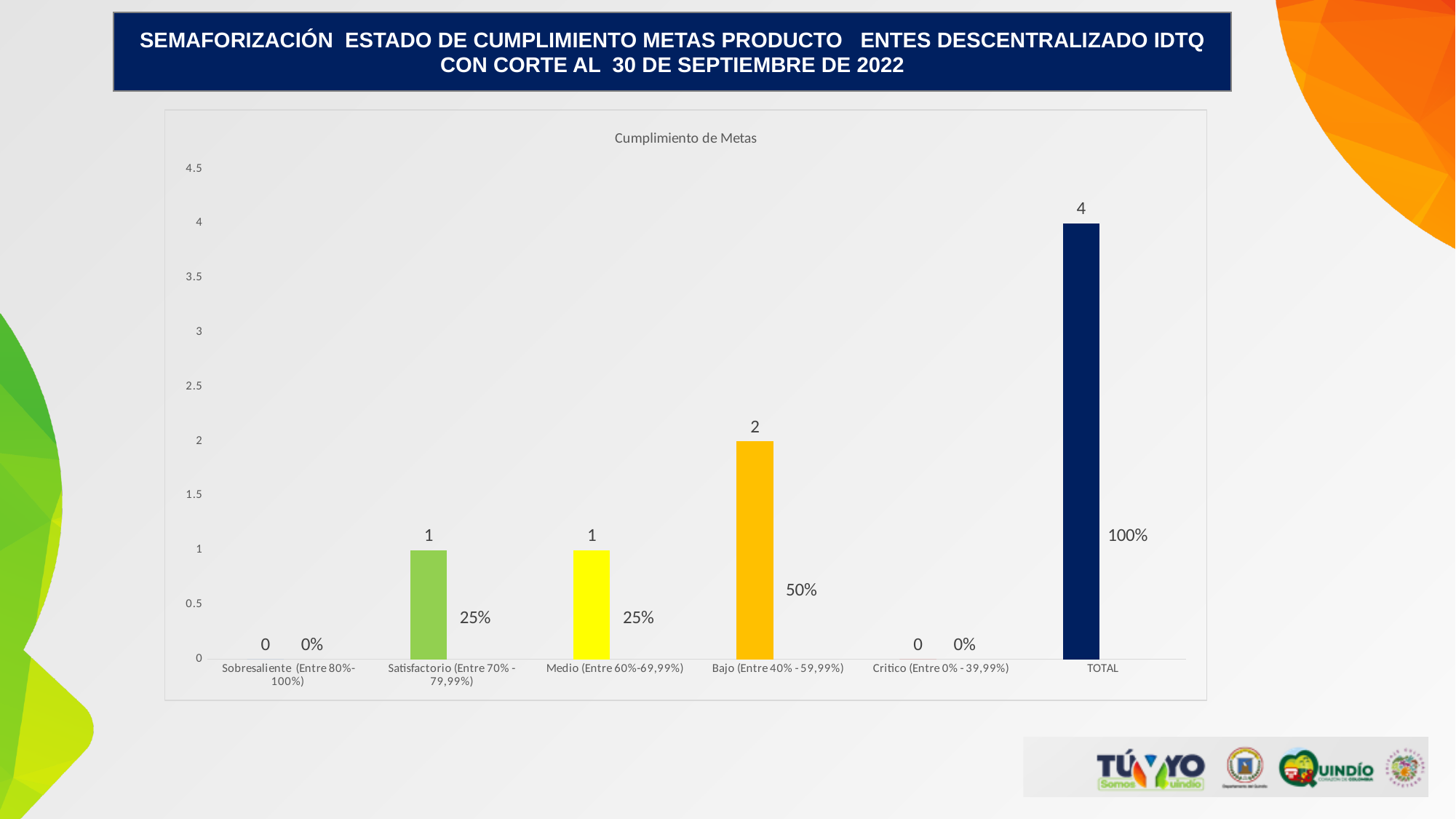
How many categories are shown on the x axis? 6 What percentage is shown for Satisfactorio (Entre 70% - 79,99%)? 25% What is the value for Bajo (Entre 40% - 59,99%)? 2 What is the difference between the values for TOTAL and Bajo (Entre 40% - 59,99%)? 2 What colour is the TOTAL bar? dark blue Excluding TOTAL, which category has the highest value? Bajo (Entre 40% - 59,99%) What percentage is shown for Bajo (Entre 40% - 59,99%)? 50% What is the value for Critico (Entre 0% - 39,99%)? 0 What kind of chart is this? bar chart What is the title of the chart? Cumplimiento de Metas What is the value for TOTAL? 4 Which is larger, the value for Medio (Entre 60%-69,99%) or the value for Bajo (Entre 40% - 59,99%)? Bajo (Entre 40% - 59,99%)